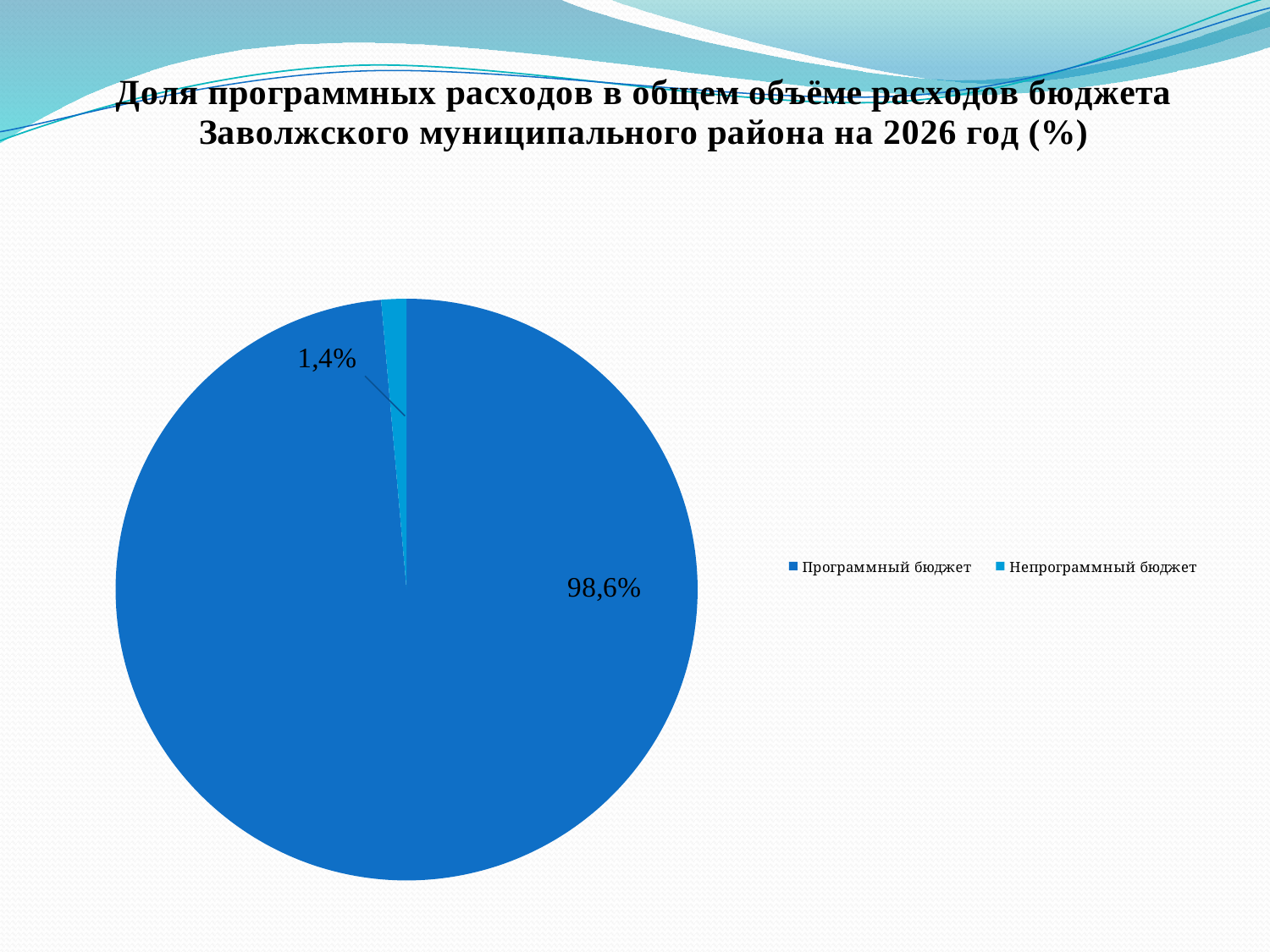
What is the value for Программный бюджет? 98,6% What is the value for Непрограммный бюджет? 1,4% What is the title of the chart? Доля программных расходов в общем объёме расходов бюджета Заволжского муниципального района на 2026 год (%) Which is larger: Программный бюджет or Непрограммный бюджет? Программный бюджет What kind of chart is shown on the slide? pie chart How many entries does the legend list? 2 Which category has the smallest share of the pie? Непрограммный бюджет How many slices does the pie chart have? 2 Which year does the chart title refer to? 2026 What is the difference between the values for Программный бюджет and Непрограммный бюджет? 97,2% Which category has the largest share of the pie? Программный бюджет